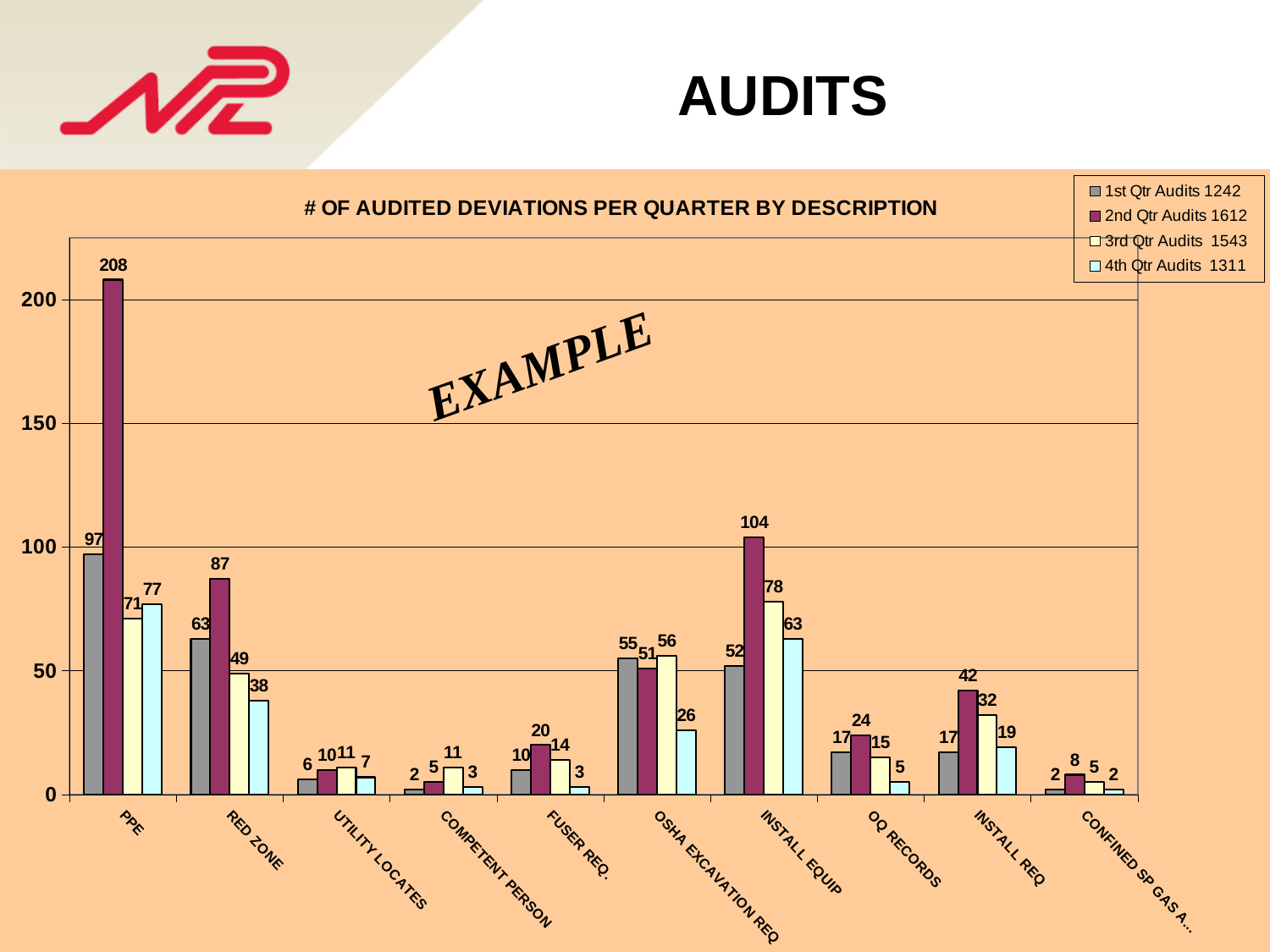
How many series does the legend list? 4 What is the 1st Qtr Audits value for OQ RECORDS? 17 What is the title of the chart? # OF AUDITED DEVIATIONS PER QUARTER BY DESCRIPTION How many categories are shown on the x axis? 10 What kind of chart is shown on the slide? Bar chart What is the 2nd Qtr Audits value for PPE? 208 Which is larger for FUSER REQ.: the 2nd Qtr Audits value or the 3rd Qtr Audits value? 2nd Qtr Audits Which category has the lowest 4th Qtr Audits value? CONFINED SP GAS A... What is the difference between the 2nd Qtr Audits and 1st Qtr Audits values for INSTALL EQUIP? 52 What is the 3rd Qtr Audits value for INSTALL EQUIP? 78 What is the 4th Qtr Audits value for RED ZONE? 38 Which category has the highest 2nd Qtr Audits value? PPE